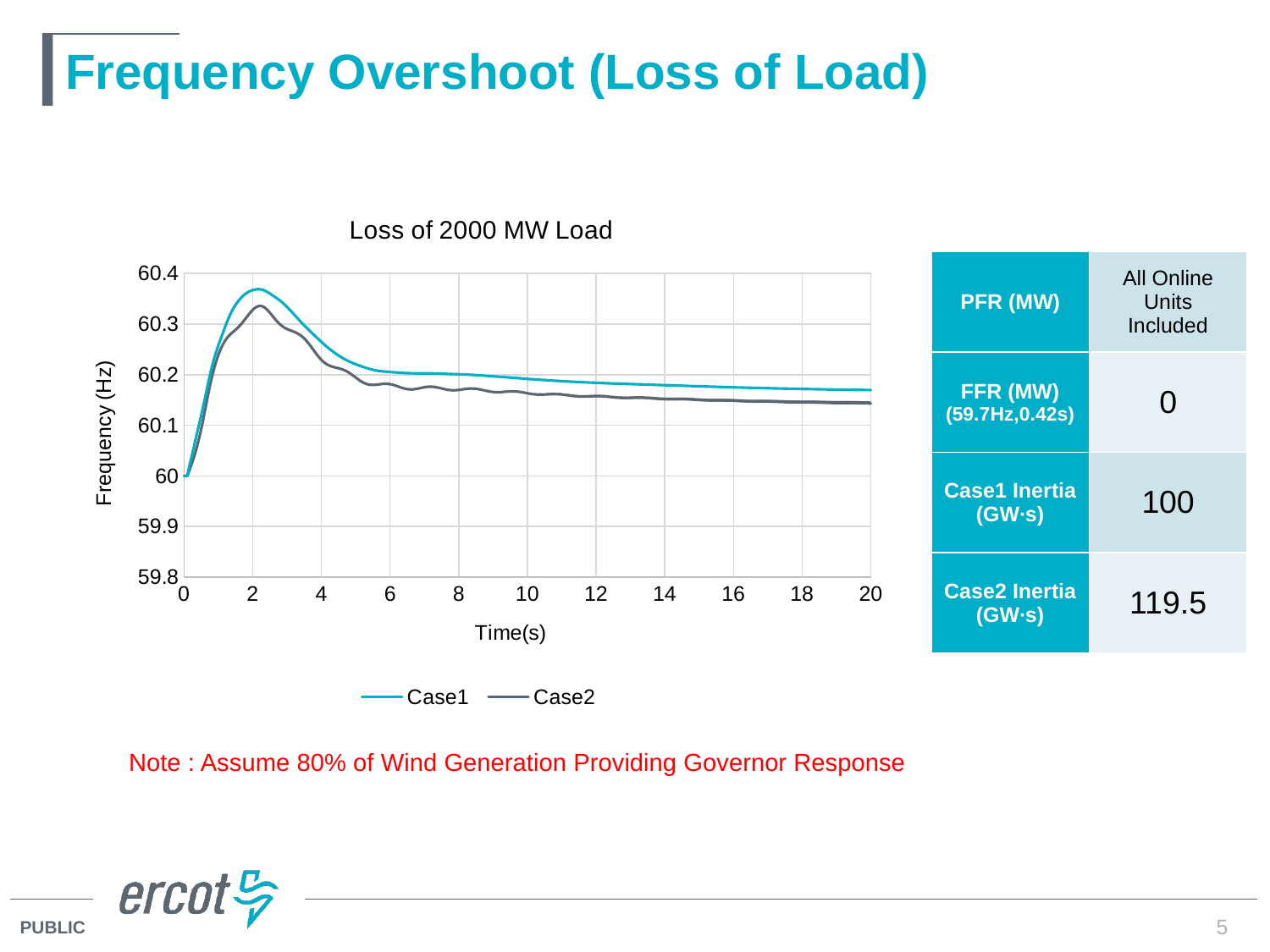
What is the frequency value for Case1 at time 0 s? 60 Is the value for Case2 at 20 s greater or less than 60.1? greater What is the title of the chart? Loss of 2000 MW Load Is the value for Case2 at 10 s greater or less than 60.2? less After reaching its peak around 2 s, does the Case1 frequency rise or fall as time increases? fall What kind of chart is shown on the slide? line chart Between 0 s and 2 s, does the Case2 frequency rise or fall? rise Is the peak value of Case1 greater or less than 60.3? greater How many series does the chart legend list? 2 Which series reaches the higher peak frequency, Case1 or Case2? Case1 What is the label of the chart's y axis? Frequency (Hz) Which series has the higher value at 20 s, Case1 or Case2? Case1